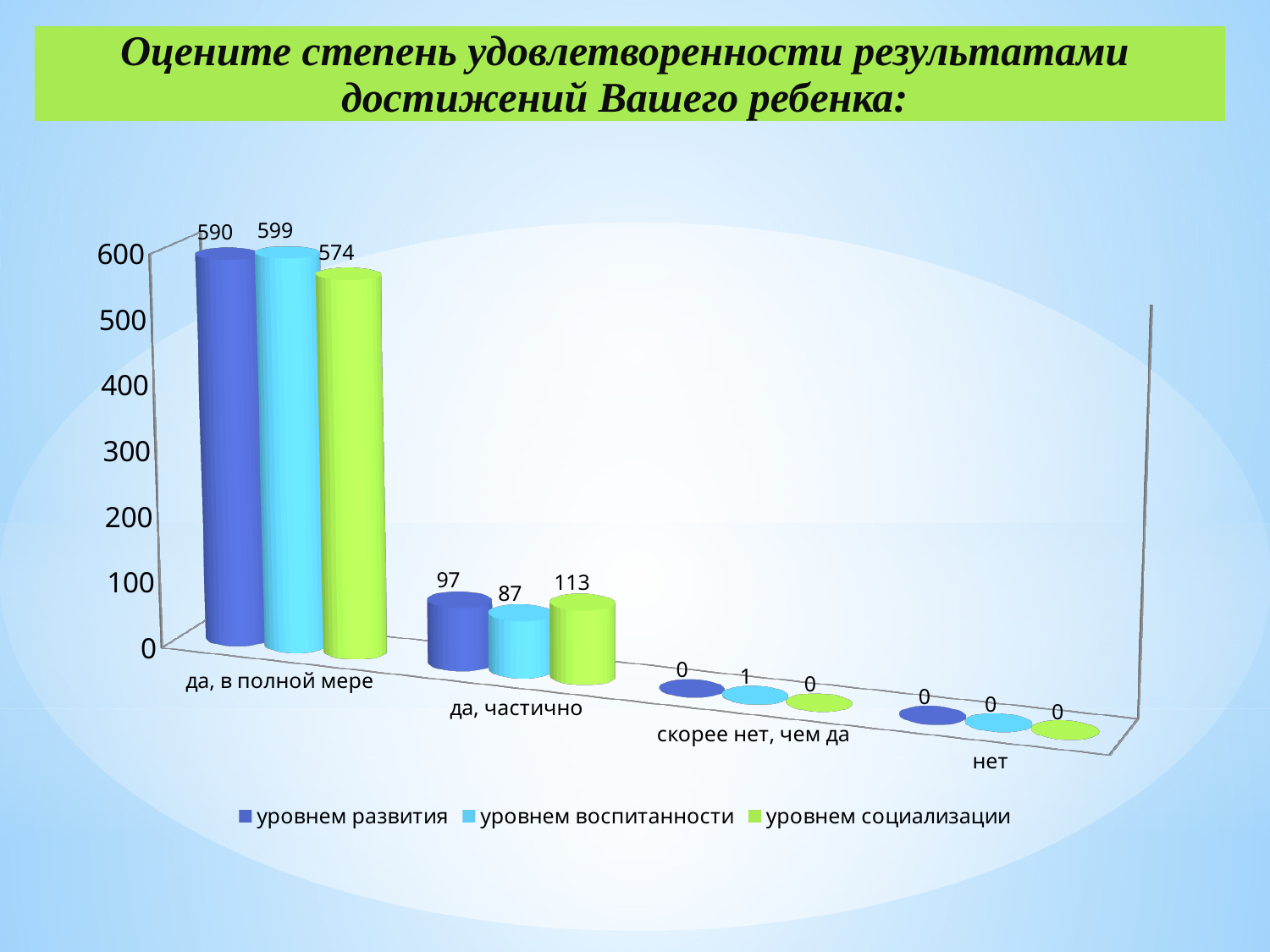
How many series does the legend list? 3 What kind of chart is shown on the slide? bar chart What is the value for "уровнем развития" in the "да, в полной мере" category? 590 Which series has the highest value in the "да, в полной мере" category? уровнем воспитанности What is the difference between the "уровнем воспитанности" and "уровнем социализации" values in the "да, в полной мере" category? 25 Which is larger for "уровнем развития": the value for "да, в полной мере" or for "да, частично"? да, в полной мере Which series has the lowest value in the "да, частично" category? уровнем воспитанности What is the value for "уровнем социализации" in the "да, частично" category? 113 What is the value for "уровнем воспитанности" in the "да, частично" category? 87 Do the values for "уровнем социализации" rise or fall from left to right along the x axis? fall What is the value for "уровнем воспитанности" in the "скорее нет, чем да" category? 1 How many categories are shown on the x axis? 4